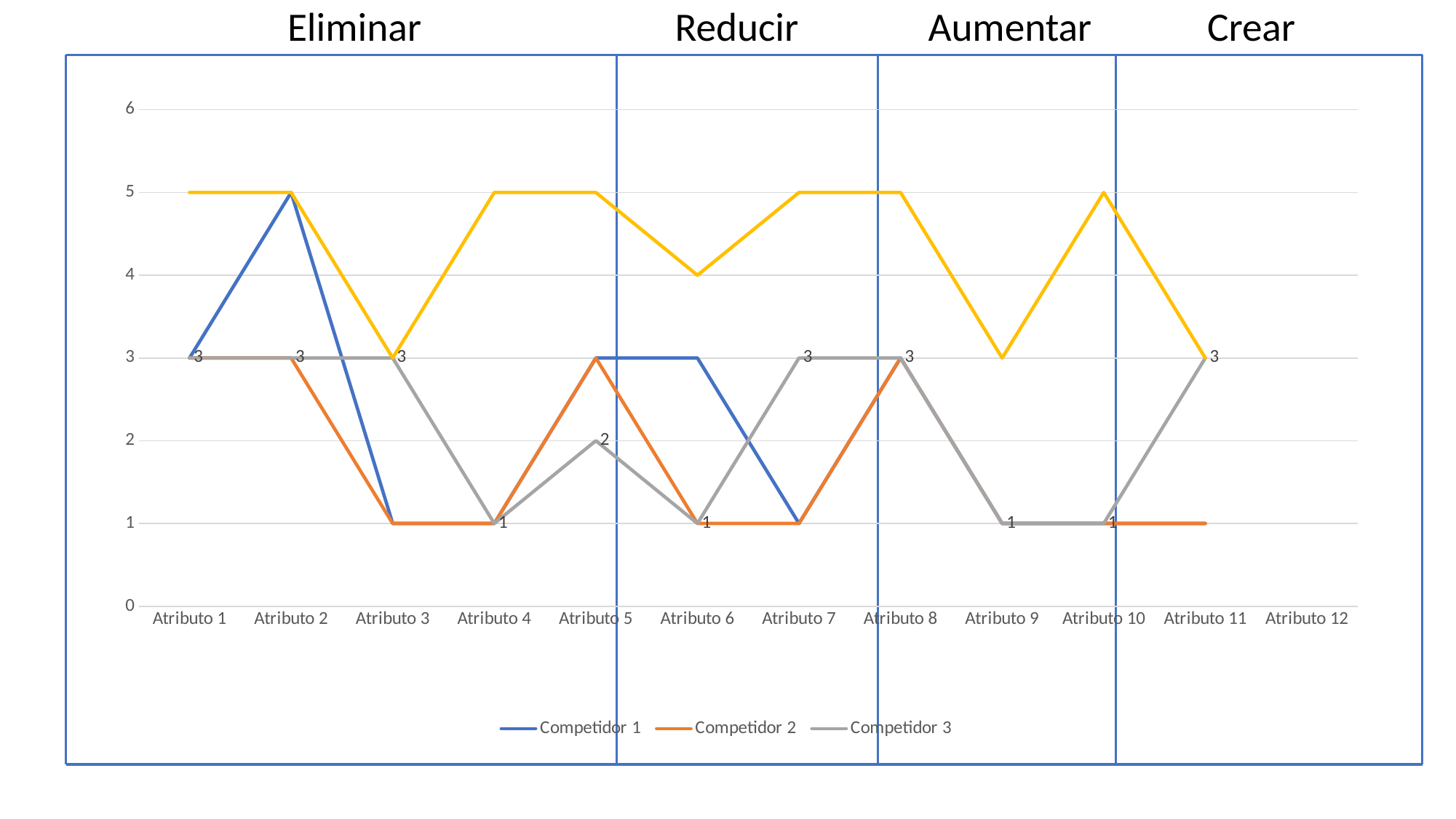
What is the value of Competidor 3 at Atributo 11? 3 How many attribute categories are shown on the x axis? 12 At Atributo 2, which is larger: Competidor 1 or Competidor 2? Competidor 1 How many series does the legend list? 3 What is the value of Competidor 1 at Atributo 2? 5 What is the difference between Competidor 3's value at Atributo 5 and at Atributo 4? 1 At which attribute does Competidor 1 reach its highest value? Atributo 2 What kind of chart is shown on the slide? line chart Is the value for Competidor 1 at Atributo 2 greater or less than 4? greater Does Competidor 3 rise or fall from Atributo 10 to Atributo 11? rise What are the four section headings written above the chart? Eliminar, Reducir, Aumentar, Crear What is the value of Competidor 3 at Atributo 5? 2